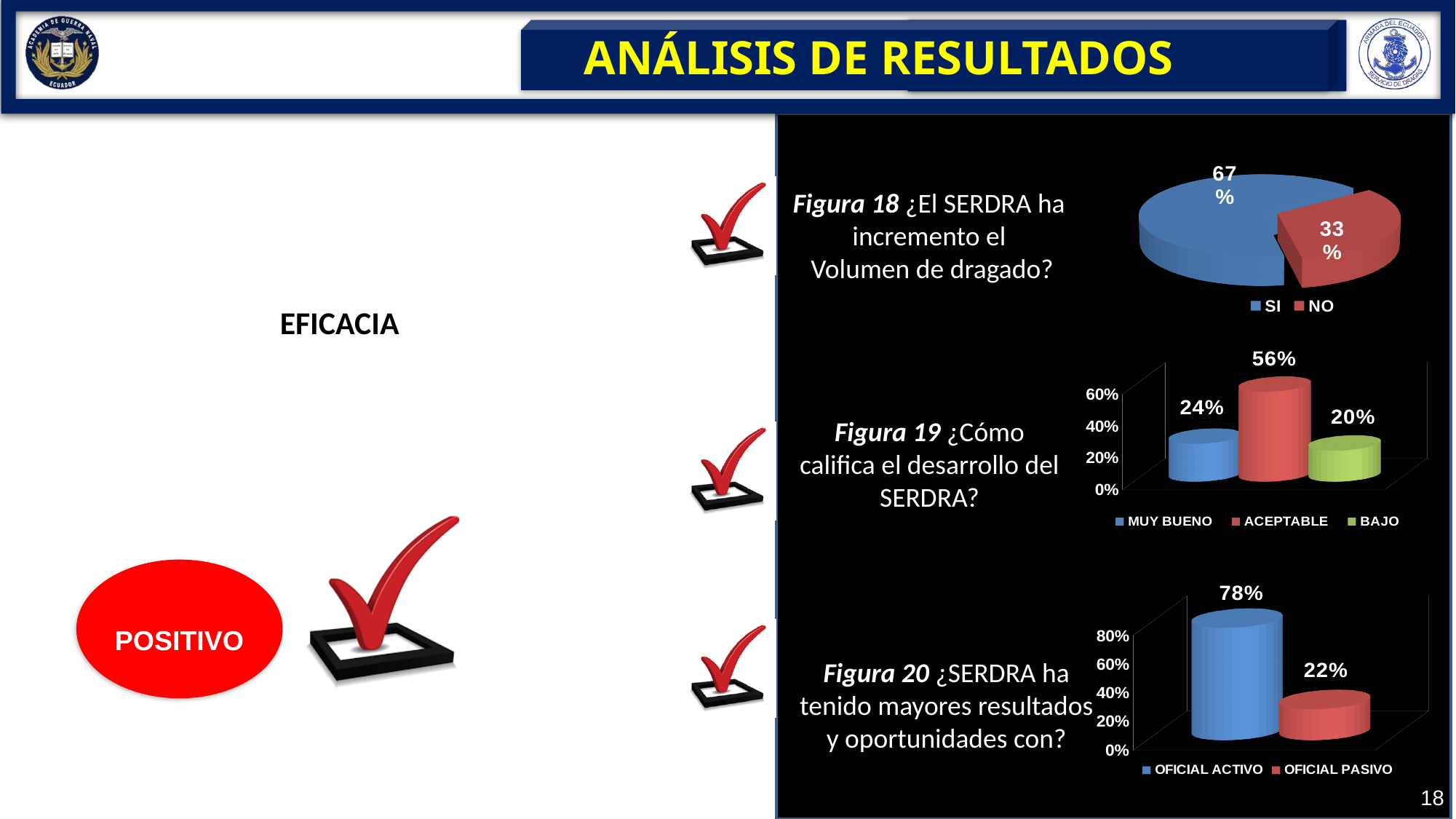
In the Figura 20 chart, which is larger, OFICIAL ACTIVO or OFICIAL PASIVO? OFICIAL ACTIVO In the Figura 18 pie chart, what percentage answered NO? 33% How many categories does the Figura 19 chart show? 3 In the Figura 19 chart, which category has the highest value? ACEPTABLE In the Figura 19 chart, what is the value for ACEPTABLE? 56% In the Figura 20 chart, what is the value for OFICIAL PASIVO? 22% What kind of chart is used for Figura 19? Bar chart In the Figura 19 chart, which category has the lowest value? BAJO In the Figura 19 chart, what is the difference between ACEPTABLE and MUY BUENO? 32% What kind of chart is used for Figura 18? Pie chart In the Figura 18 pie chart, what percentage answered SI? 67% In the Figura 20 chart, what is the difference between OFICIAL ACTIVO and OFICIAL PASIVO? 56%